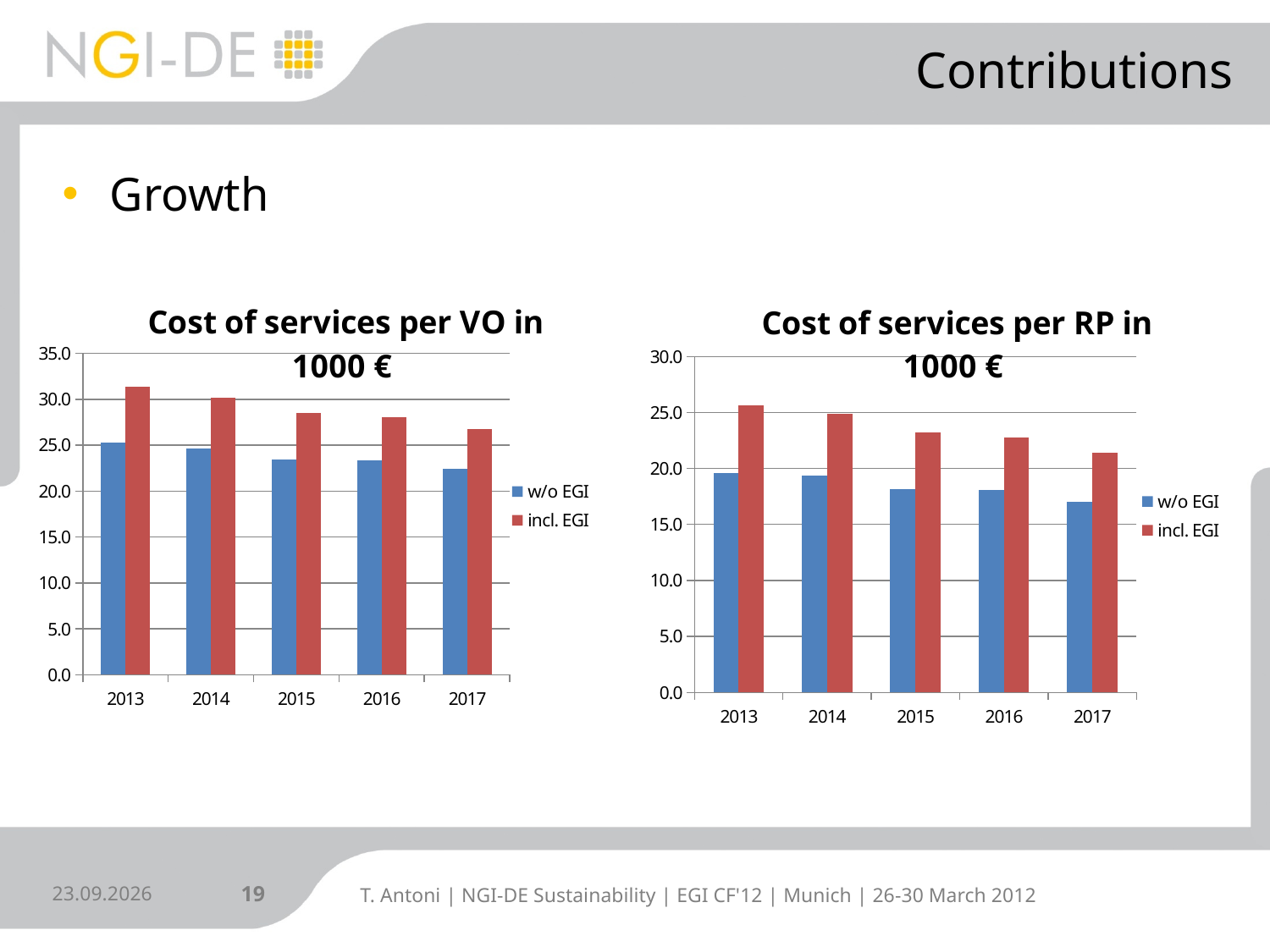
In the "Cost of services per RP in 1000 €" chart, which year has the lowest w/o EGI value? 2017 In the "Cost of services per VO in 1000 €" chart, do the incl. EGI values rise or fall from 2013 to 2017? fall What are the two legend entries in the "Cost of services per RP in 1000 €" chart? w/o EGI and incl. EGI In the "Cost of services per RP in 1000 €" chart, do the w/o EGI values rise or fall from 2013 to 2017? fall What kind of chart is the "Cost of services per VO in 1000 €" chart? bar chart In the "Cost of services per RP in 1000 €" chart, is the w/o EGI value for 2017 greater or less than 20.0? less In the "Cost of services per VO in 1000 €" chart, which year has the highest incl. EGI value? 2013 How many years are shown on the x axis of the "Cost of services per VO in 1000 €" chart? 5 In the "Cost of services per VO in 1000 €" chart, is the incl. EGI value for 2013 greater or less than 30.0? greater In the "Cost of services per RP in 1000 €" chart, which is larger: the incl. EGI value for 2013 or for 2017? 2013 How many series does the legend of the "Cost of services per VO in 1000 €" chart list? 2 In the "Cost of services per VO in 1000 €" chart, is the w/o EGI value for 2017 greater or less than 25.0? less